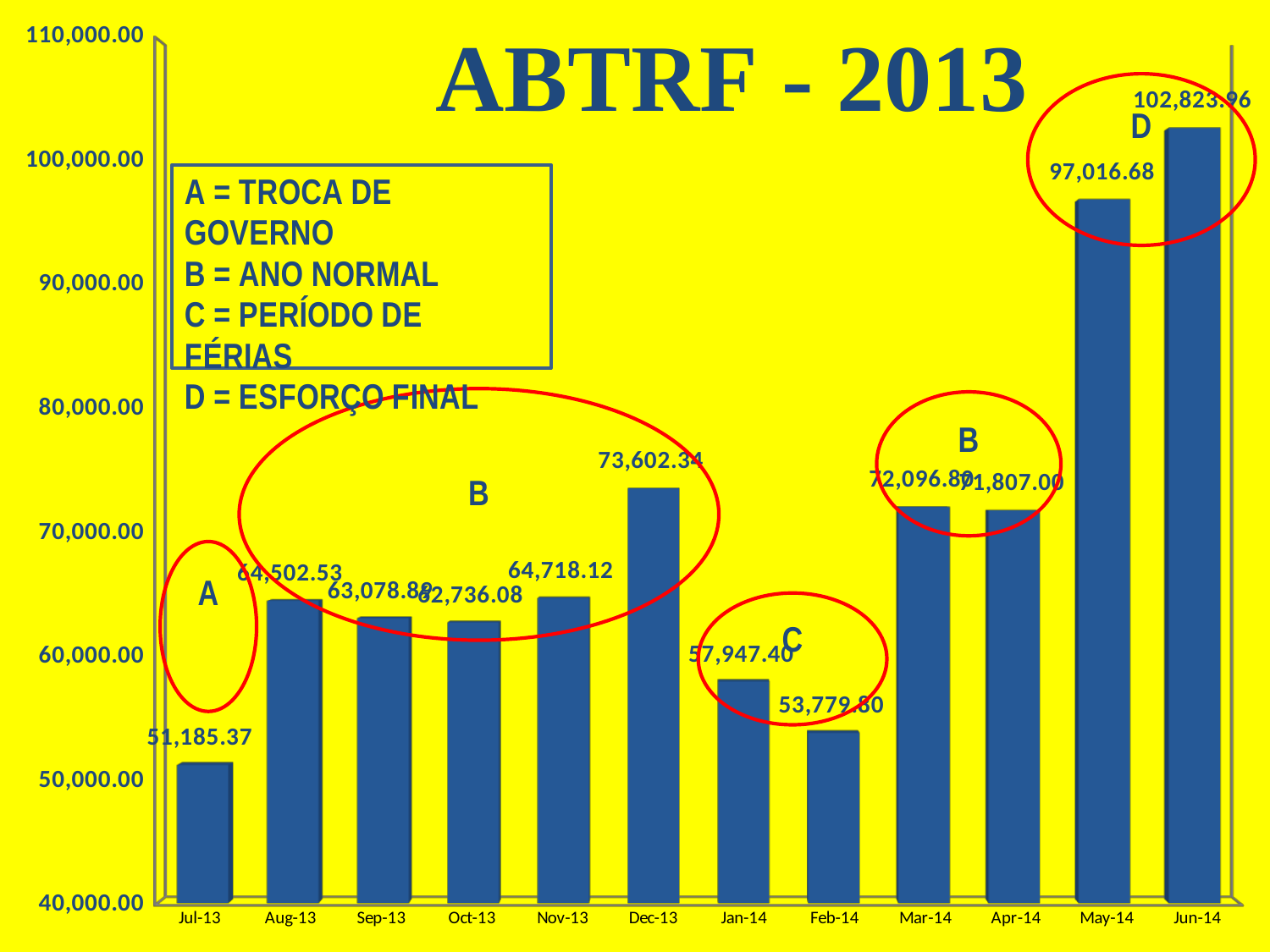
What is the title of the chart? ABTRF - 2013 Which is larger, the value for Dec-13 or the value for Apr-14? Dec-13 Which month has the highest value? Jun-14 What is the value for Feb-14? 53,779.80 What is the value for Jul-13? 51,185.37 What is the difference between the values for Jun-14 and May-14? 5,807.28 How many months are shown on the x axis? 12 Which month has the lowest value? Jul-13 Is the value for May-14 greater or less than 100,000.00? less What is the value for Jun-14? 102,823.96 What is the value for Dec-13? 73,602.34 What kind of chart is shown on the slide? bar chart